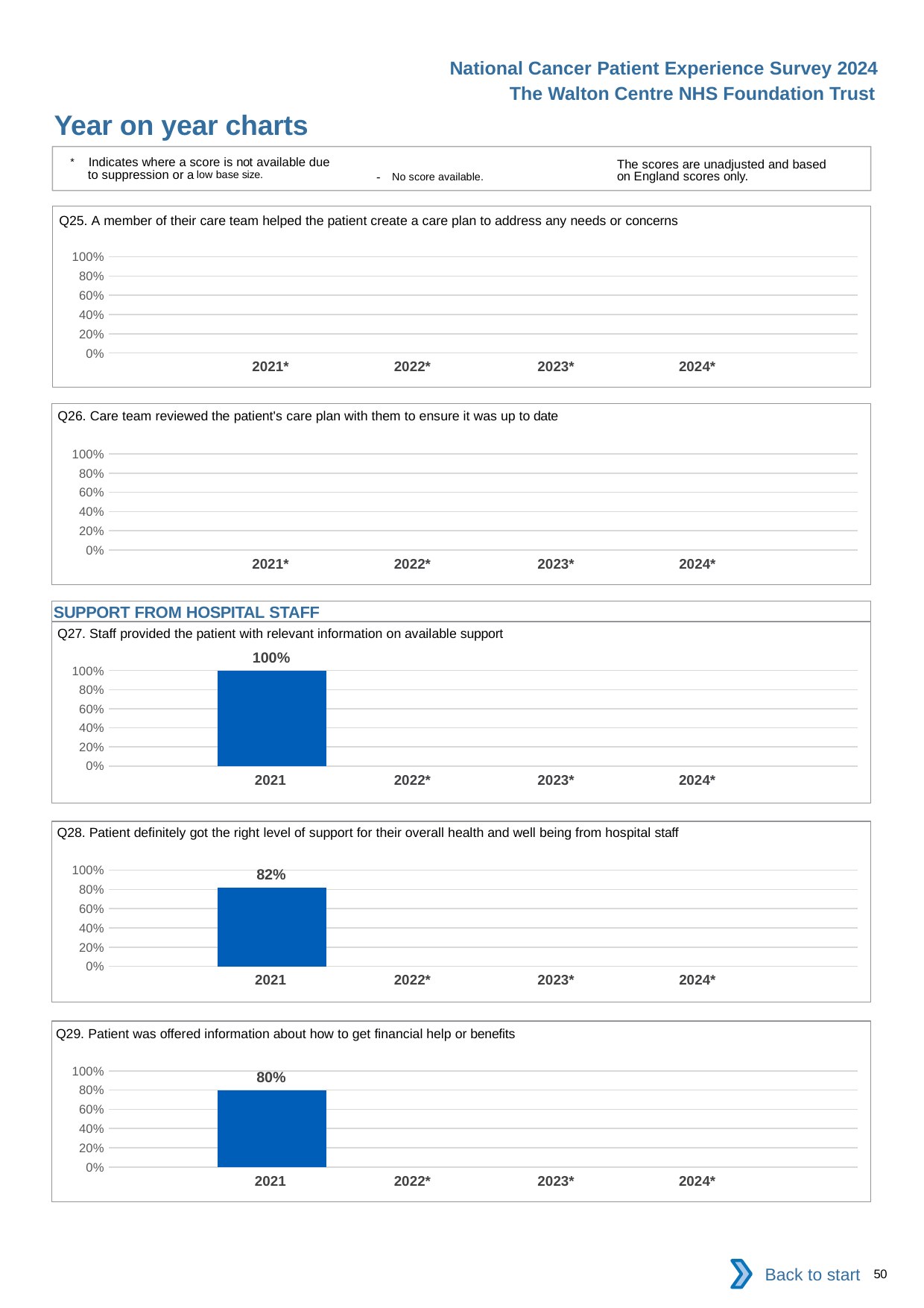
In the Q29 chart, which years are marked with an asterisk indicating no available score? 2022, 2023, 2024 In the Q28 chart, is the value for 2021 greater or less than 60%? greater In the Q29 chart, what is the value for 2021? 80% In the Q28 chart, what is the value for 2021? 82% How many year categories are shown on the x axis of the Q25 chart? 4 What kind of chart is the Q28 chart? bar chart In the Q27 chart, is the value for 2021 greater or less than 80%? greater Which is larger: the 2021 value in the Q27 chart or the 2021 value in the Q29 chart? Q27 chart (100%) How many charts on the slide have no bars plotted at all? 2 What is the difference between the 2021 value in the Q27 chart and the 2021 value in the Q28 chart? 18% What is the difference between the 2021 value in the Q28 chart and the 2021 value in the Q29 chart? 2% In the Q27 chart, what is the value for 2021? 100%